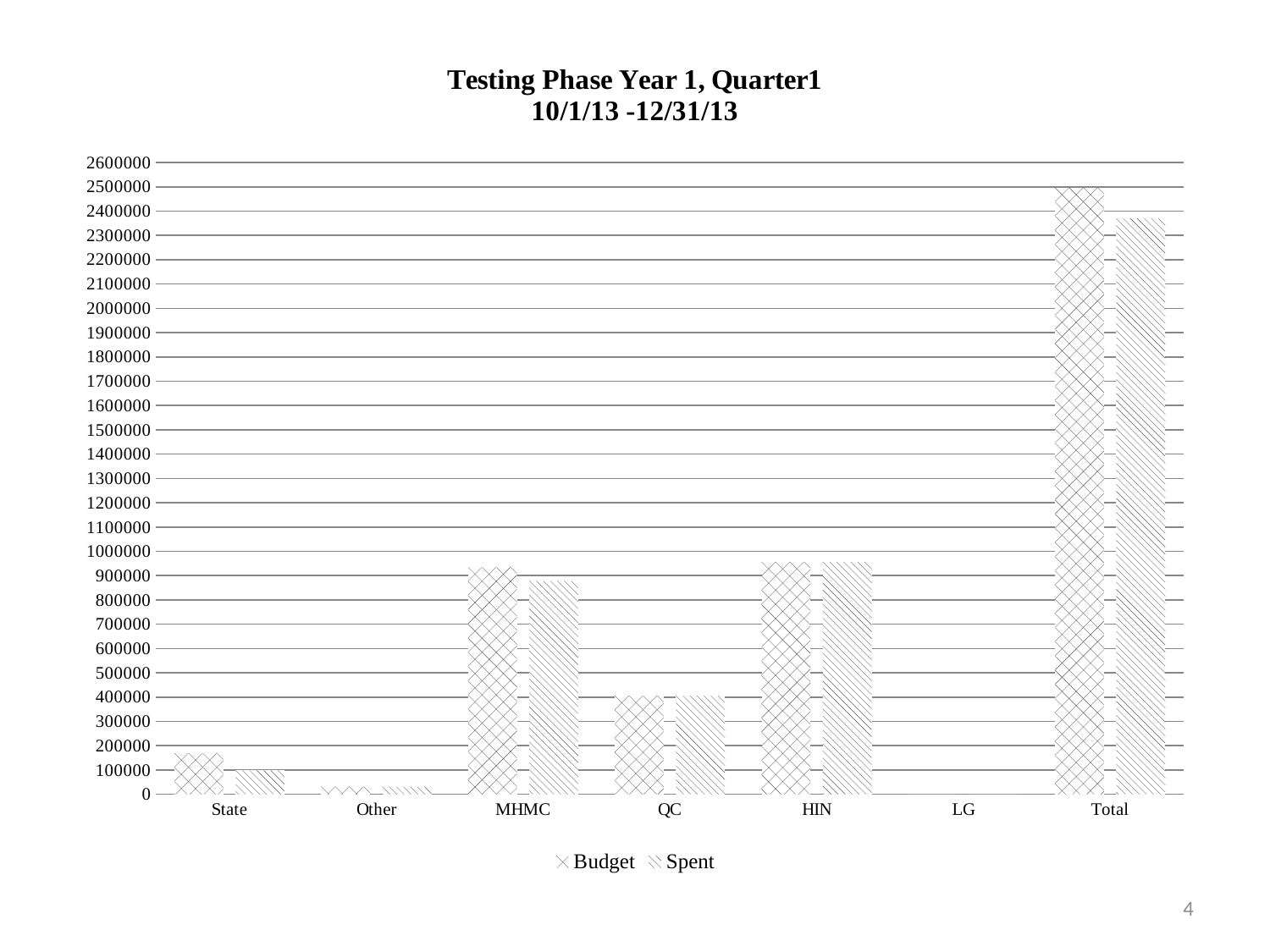
Is the Budget value for State greater or less than 200000? less How many categories are shown on the x axis? 7 What are the two series named in the legend? Budget and Spent Which category has the highest Budget value? Total Is the Spent value for QC greater or less than 500000? less How many series does the legend list? 2 What kind of chart is shown on the slide? bar chart Which is larger, the Budget value for MHMC or the Budget value for QC? MHMC Is the Spent value for Total greater or less than 2400000? less Which category has the highest Spent value? Total Which is larger for State, the Budget value or the Spent value? Budget